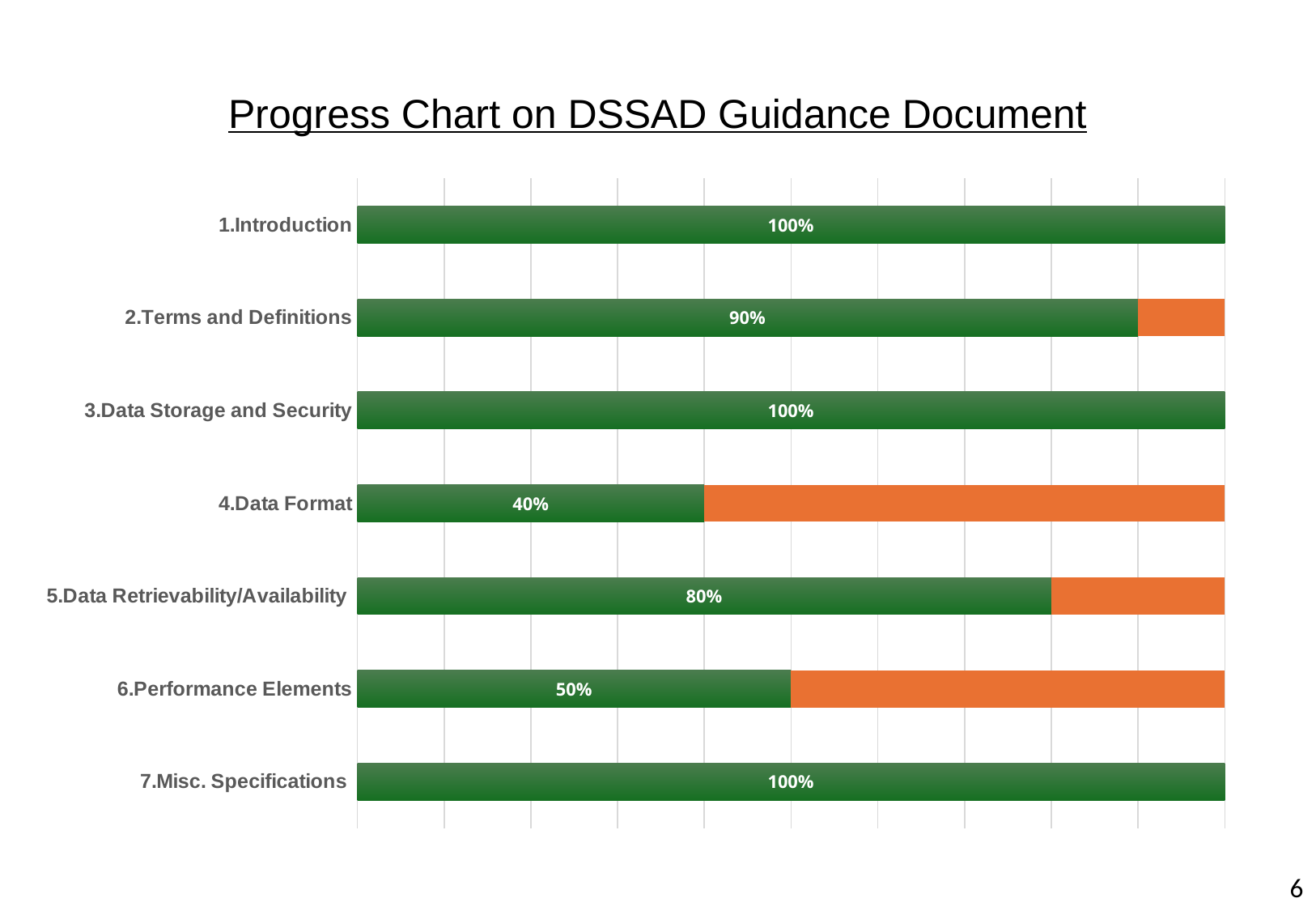
What is the progress value shown for 4.Data Format? 40% What is the progress value shown for 6.Performance Elements? 50% What is the difference between the progress values for 2.Terms and Definitions and 4.Data Format? 50% What is the progress value shown for 7.Misc. Specifications? 100% Which has a higher progress value, 5.Data Retrievability/Availability or 6.Performance Elements? 5.Data Retrievability/Availability What type of chart is shown on the slide? Bar chart How many categories show a progress value of 100%? 3 What is the progress value shown for 5.Data Retrievability/Availability? 80% What is the progress value shown for 2.Terms and Definitions? 90% How many categories are shown in the chart? 7 Which category has the lowest progress value? 4.Data Format What is the difference between the progress values for 5.Data Retrievability/Availability and 6.Performance Elements? 30%